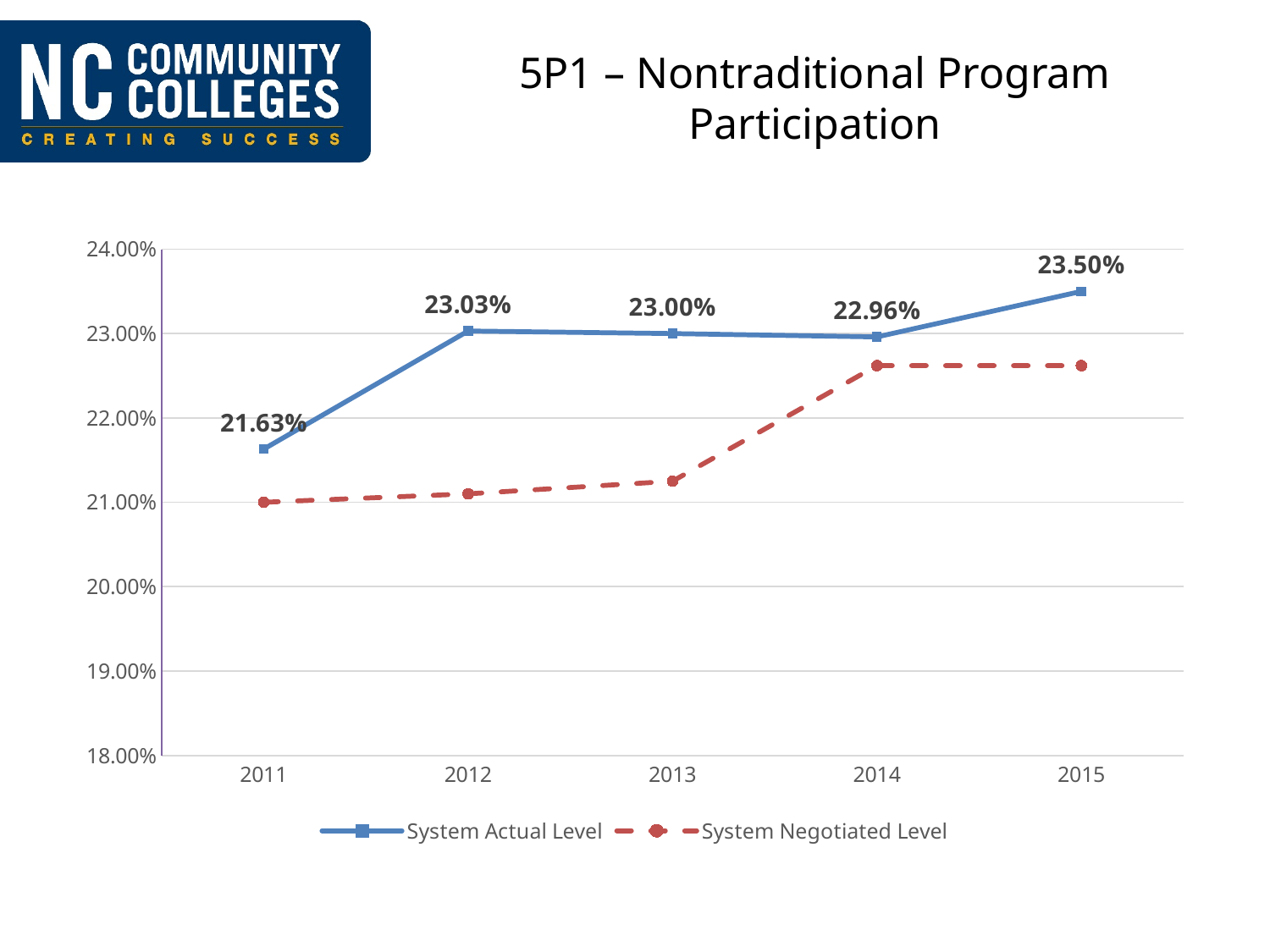
In which year is the System Actual Level lowest? 2011 Which year has the larger System Actual Level, 2012 or 2014? 2012 Is the System Negotiated Level for 2014 greater or less than 22.00%? greater What kind of chart is shown on the slide? Line chart What is the System Actual Level value for 2011? 21.63% How many series does the legend list? 2 In which year is the System Actual Level highest? 2015 What is the System Actual Level value for 2015? 23.50% Is the System Negotiated Level for 2012 greater or less than 22.00%? less What is the difference between the System Actual Level in 2015 and in 2011? 1.87% What is the System Actual Level value for 2013? 23.00% How many years are shown on the x axis? 5